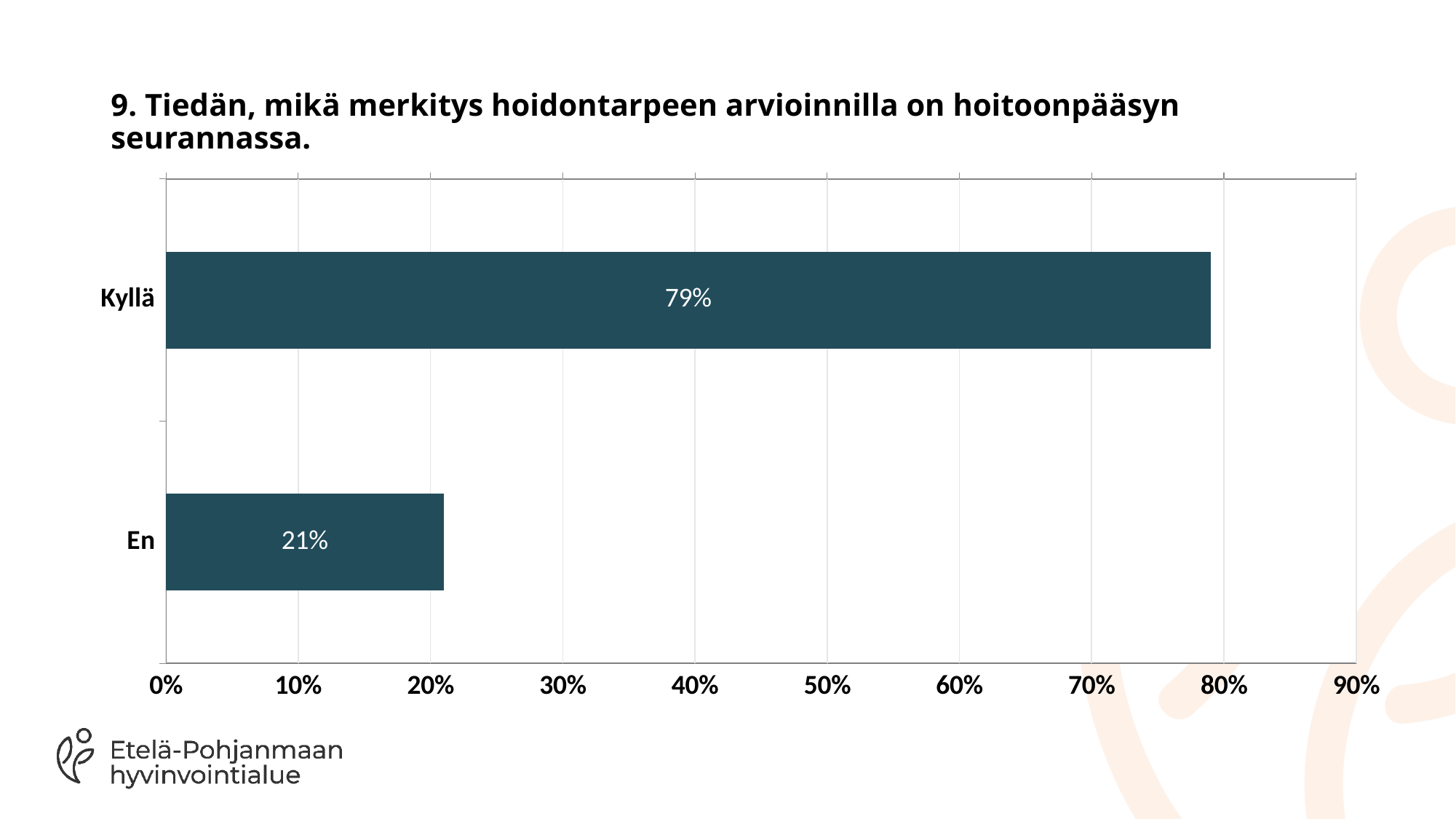
How many categories are shown in the chart? 2 What is the value for Kyllä? 79% What is the value for En? 21% What is the title of the chart? 9. Tiedän, mikä merkitys hoidontarpeen arvioinnilla on hoitoonpääsyn seurannassa. Which category has the lowest value? En What is the highest value shown on the x axis? 90% Is the value for En greater or less than 30%? less What kind of chart is shown on the slide? bar chart Which is larger, the value for Kyllä or the value for En? Kyllä Is the value for Kyllä greater or less than 70%? greater Which category has the highest value? Kyllä What is the difference between the values for Kyllä and En? 58%